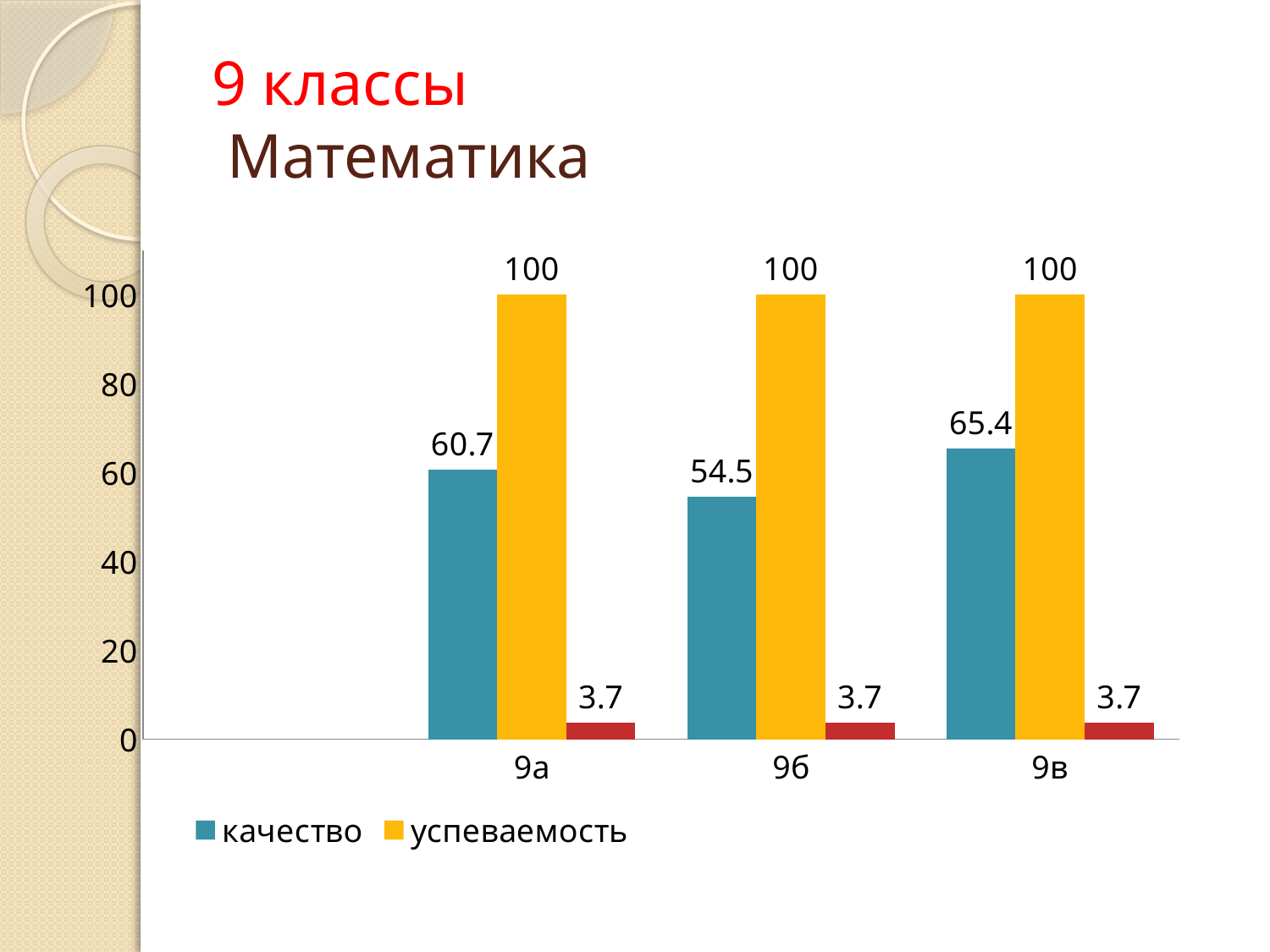
How many series does the legend list? 2 Which class has the lowest качество value? 9б What is the value of качество for class 9а? 60.7 What is the value of успеваемость for class 9б? 100 What kind of chart is shown on the slide? bar chart What is the difference between the качество values of 9в and 9б? 10.9 What is the value of качество for class 9б? 54.5 What is the value of качество for class 9в? 65.4 How many classes (categories) are shown on the x axis? 3 Which is larger, the качество value for 9а or for 9б? 9а Which class has the highest качество value? 9в What is the value shown on the small red bar for class 9в? 3.7